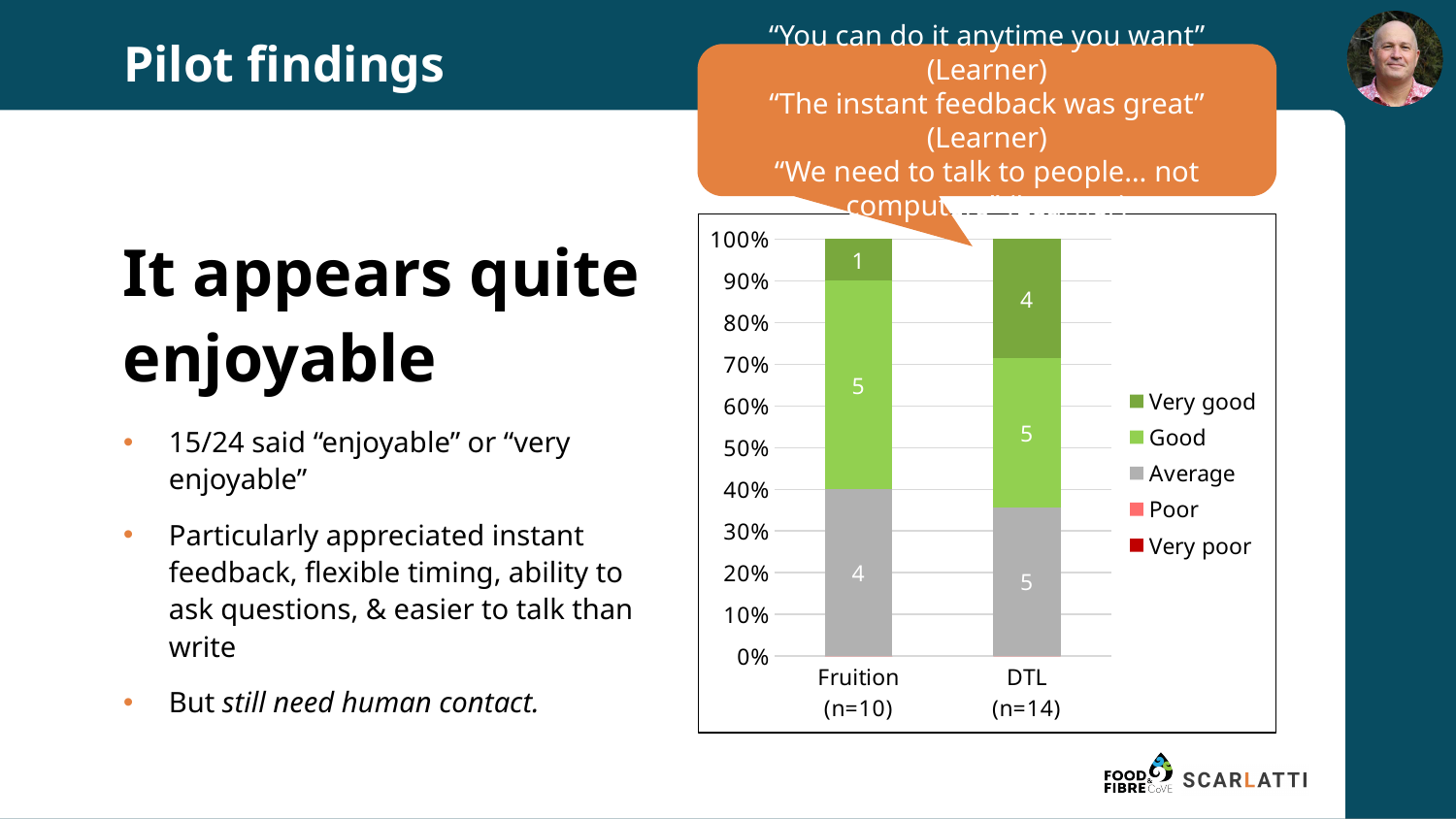
What is the total of the labelled values in the DTL (n=14) bar? 14 How many series does the chart's legend list? 5 What is the 'Good' value for DTL (n=14)? 5 Which legend entries have no visible segment in either bar? Poor and Very poor What is the difference between the 'Very good' values for DTL and Fruition? 3 What is the 'Very good' value for DTL (n=14)? 4 How many categories are shown on the x axis of the chart? 2 What is the 'Very good' value for Fruition (n=10)? 1 Which category has the higher 'Very good' value, Fruition or DTL? DTL Is the 'Average' share of the DTL (n=14) bar greater or less than 40%? less What is the 'Average' value for Fruition (n=10)? 4 What kind of chart is shown on the slide? Stacked bar chart